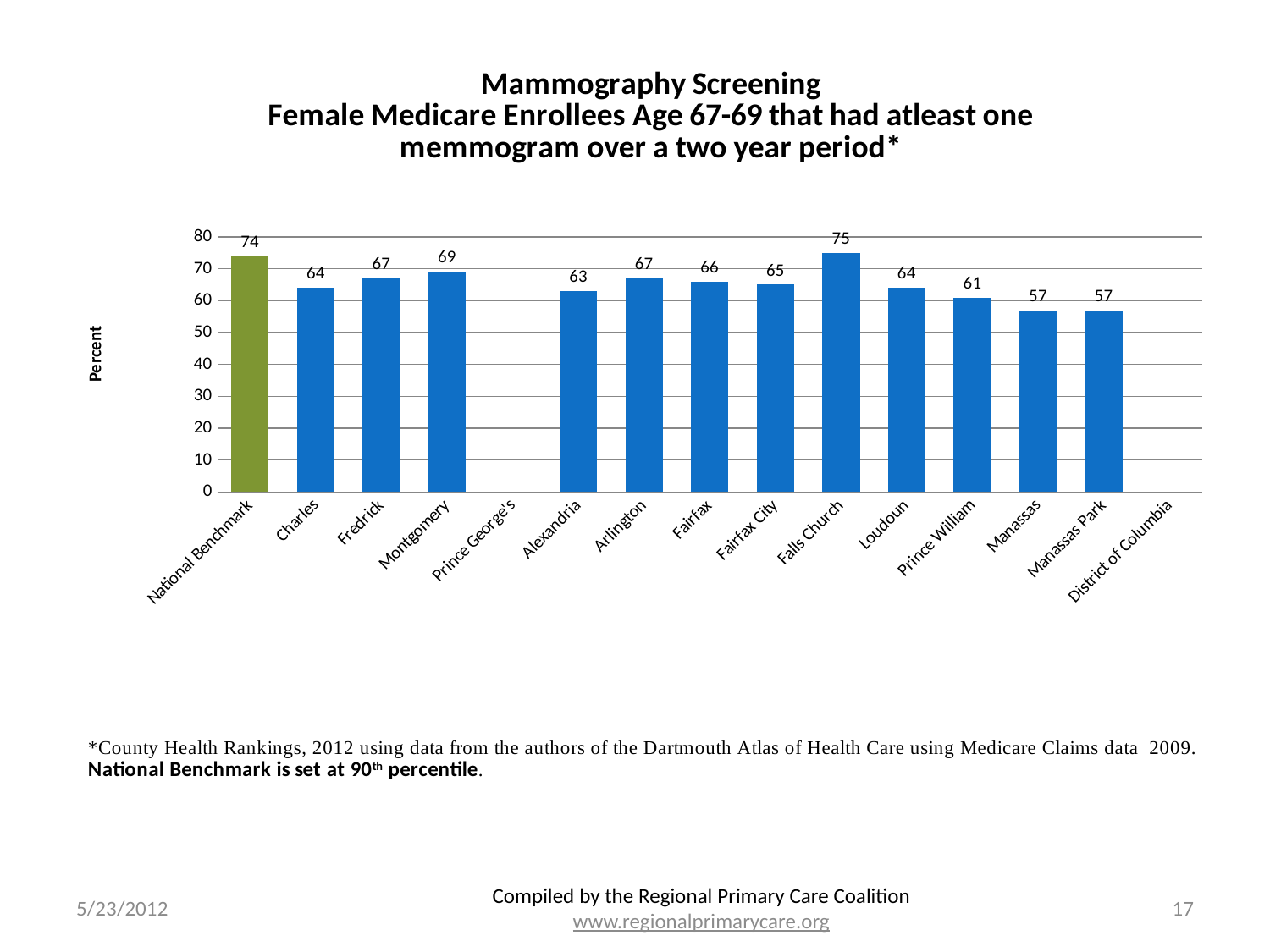
What is the value for Falls Church? 75 How many categories are labelled on the x axis? 15 What is the difference between the Falls Church value and the National Benchmark value? 1 Which bar is coloured green rather than blue? National Benchmark What is the value for Prince William? 61 What is the value for the National Benchmark? 74 Which is larger, the value for Fredrick or the value for Alexandria? Fredrick Is the value for Loudoun greater or less than 70? less What kind of chart is shown on the slide? bar chart What is the difference between the Montgomery value and the Manassas value? 12 What is the value for Montgomery? 69 Which category has the highest value? Falls Church